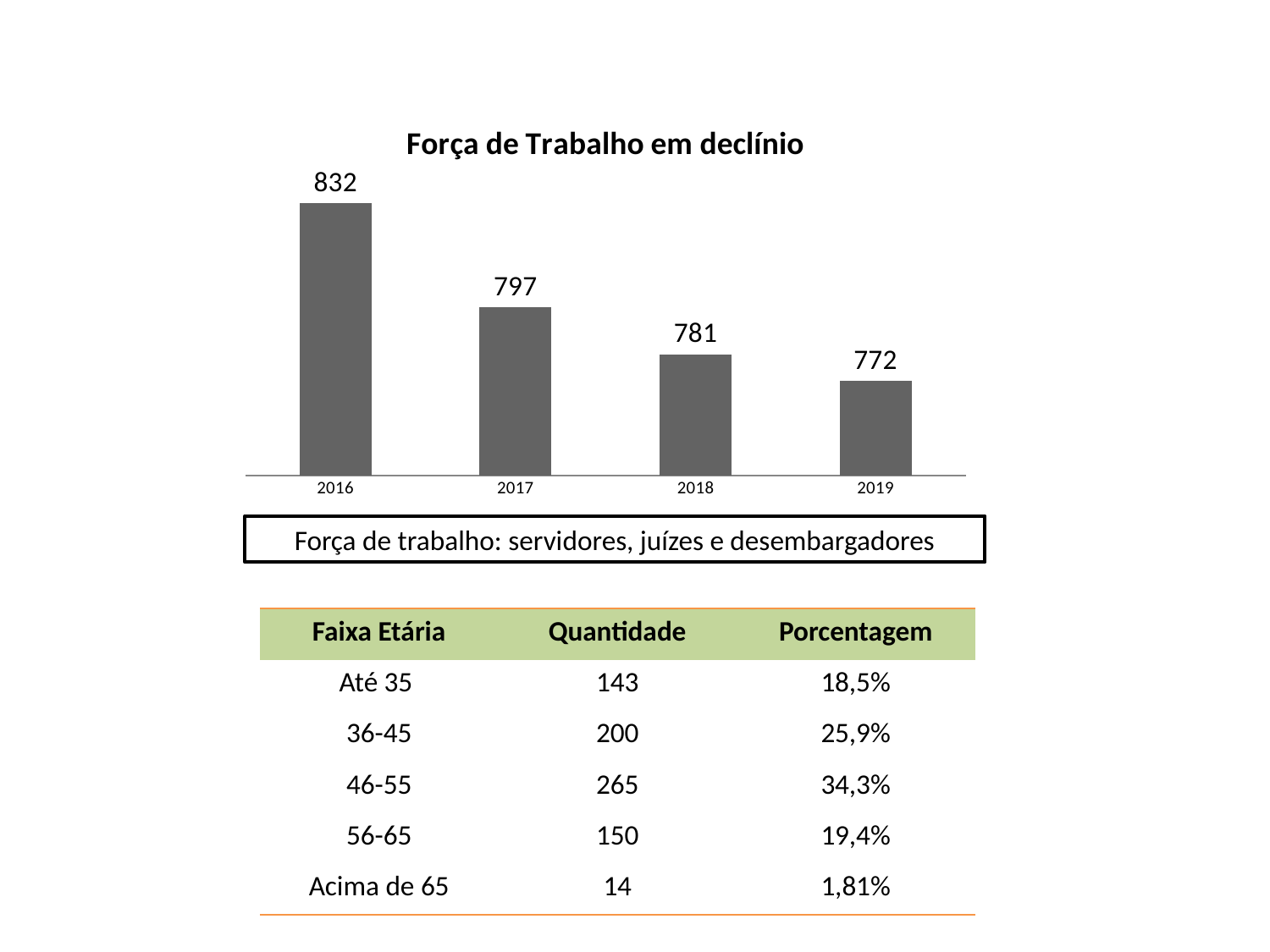
Which is larger, the value for 2017 or the value for 2018? 2017 Which year has the highest value in the chart? 2016 Which year has the lowest value in the chart? 2019 What is the value for 2017 in the chart? 797 What is the value for 2018 in the chart? 781 How many years are shown in the chart? 4 What kind of chart is shown on the slide? Bar chart What is the difference between the values for 2016 and 2019? 60 What is the value for 2019 in the chart? 772 Do the values rise or fall from 2016 to 2019? Fall What is the difference between the values for 2017 and 2018? 16 What is the value for 2016 in the chart? 832